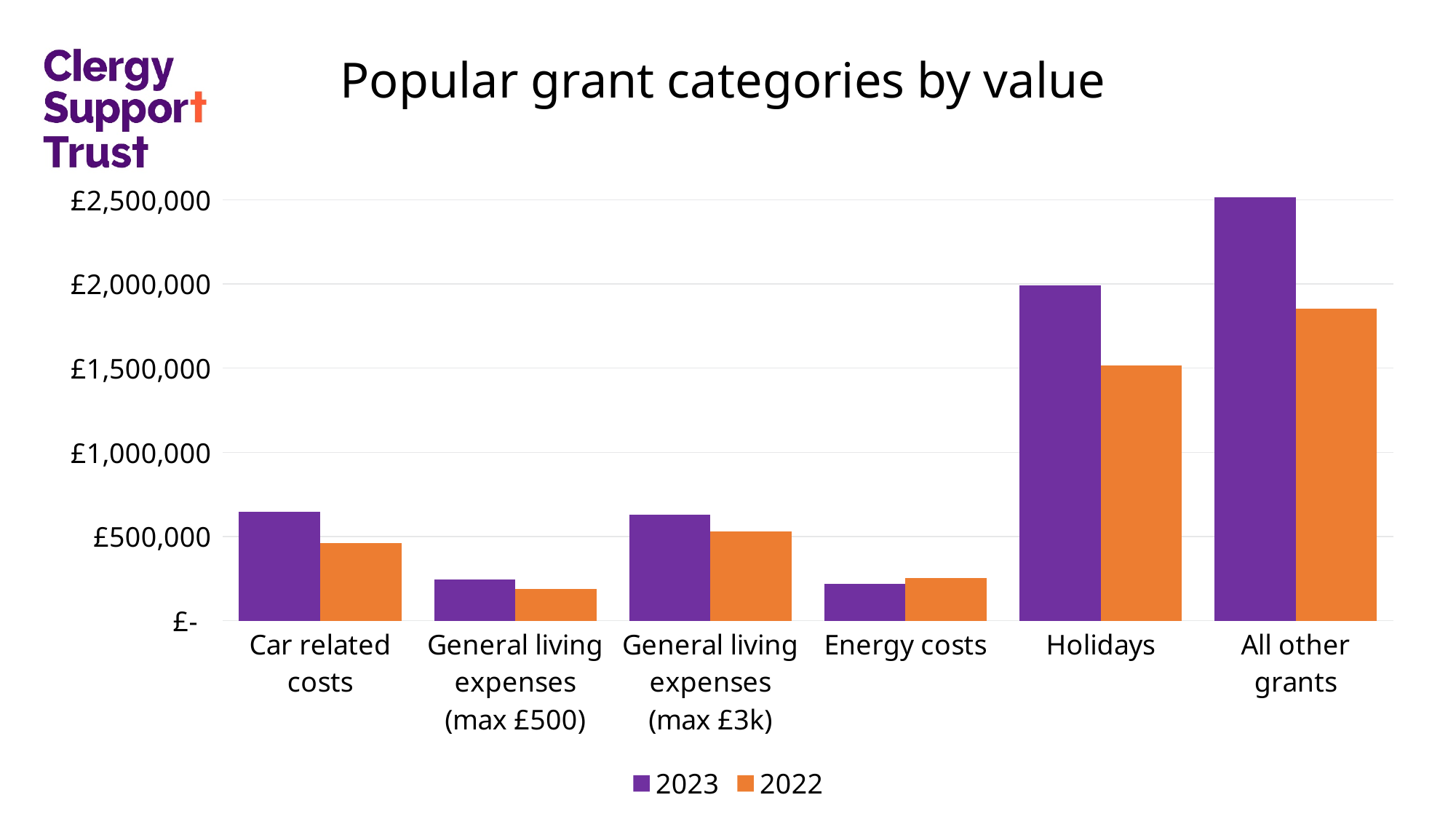
What is the title of the chart? Popular grant categories by value Is the 2023 value for Holidays greater or less than £1,500,000? greater Is the 2022 value for Energy costs greater or less than £500,000? less Which colour represents the 2022 series in the chart? orange Is the 2022 value for All other grants greater or less than £2,000,000? less For Holidays, which year has the larger value, 2023 or 2022? 2023 Which category has the highest value for 2023? All other grants What kind of chart is shown on the slide? bar chart How many grant categories are shown on the x axis? 6 Which category has the lowest value for 2022? General living expenses (max £500) How many series does the legend list? 2